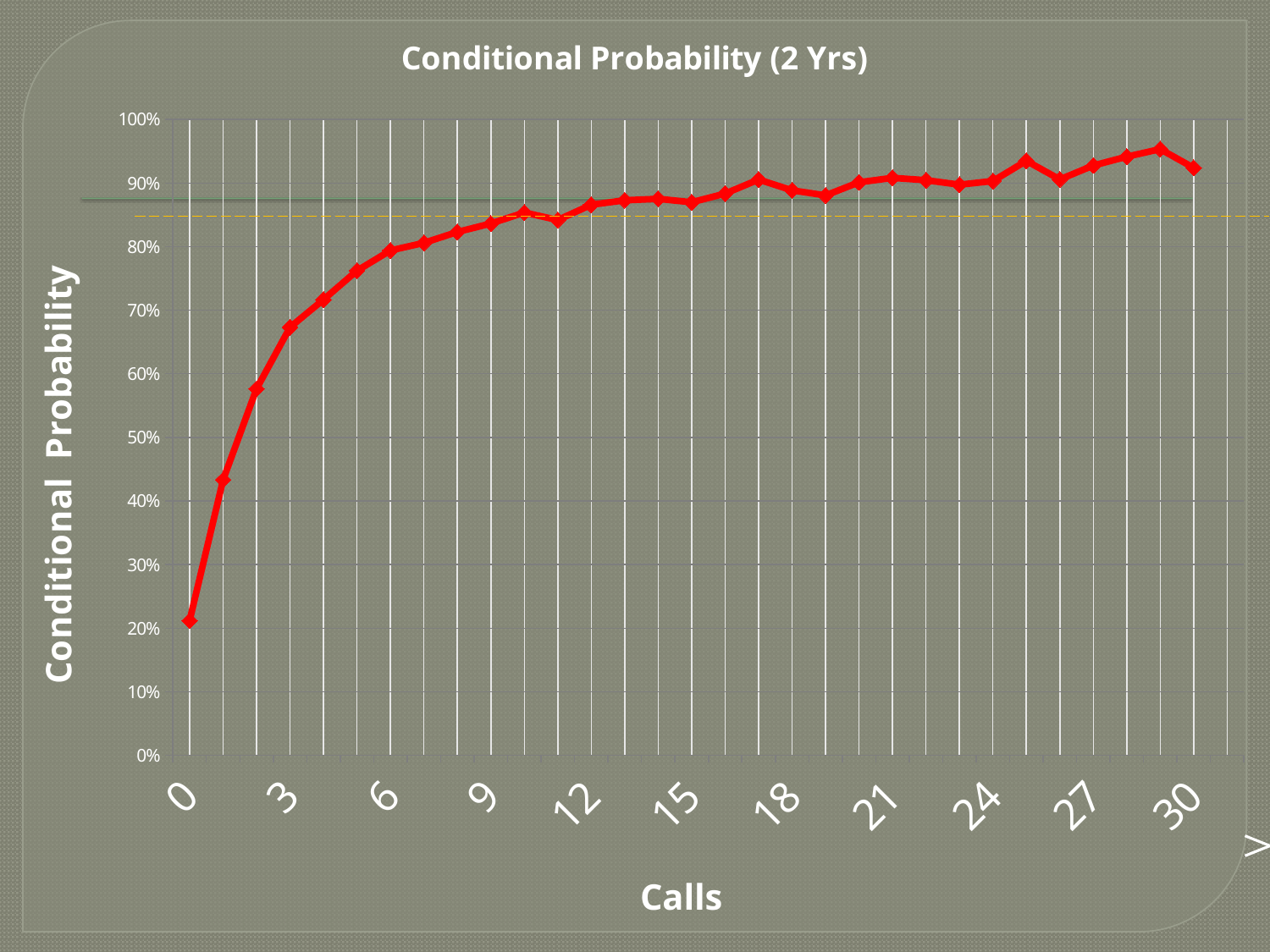
Is the value at 0 calls greater or less than 30%? less At which number of calls is the conditional probability lowest? 0 What kind of chart is shown on the slide? Line chart Is the value at 15 calls greater or less than 90%? less Do the values generally rise or fall as the number of calls increases? Rise What is the label of the x axis? Calls Is the value at 3 calls greater or less than 60%? greater At which number of calls is the conditional probability highest? 29 What is the title of the chart? Conditional Probability (2 Yrs) Which is larger, the value at 0 calls or the value at 30 calls? 30 calls How many data points are plotted on the line? 31